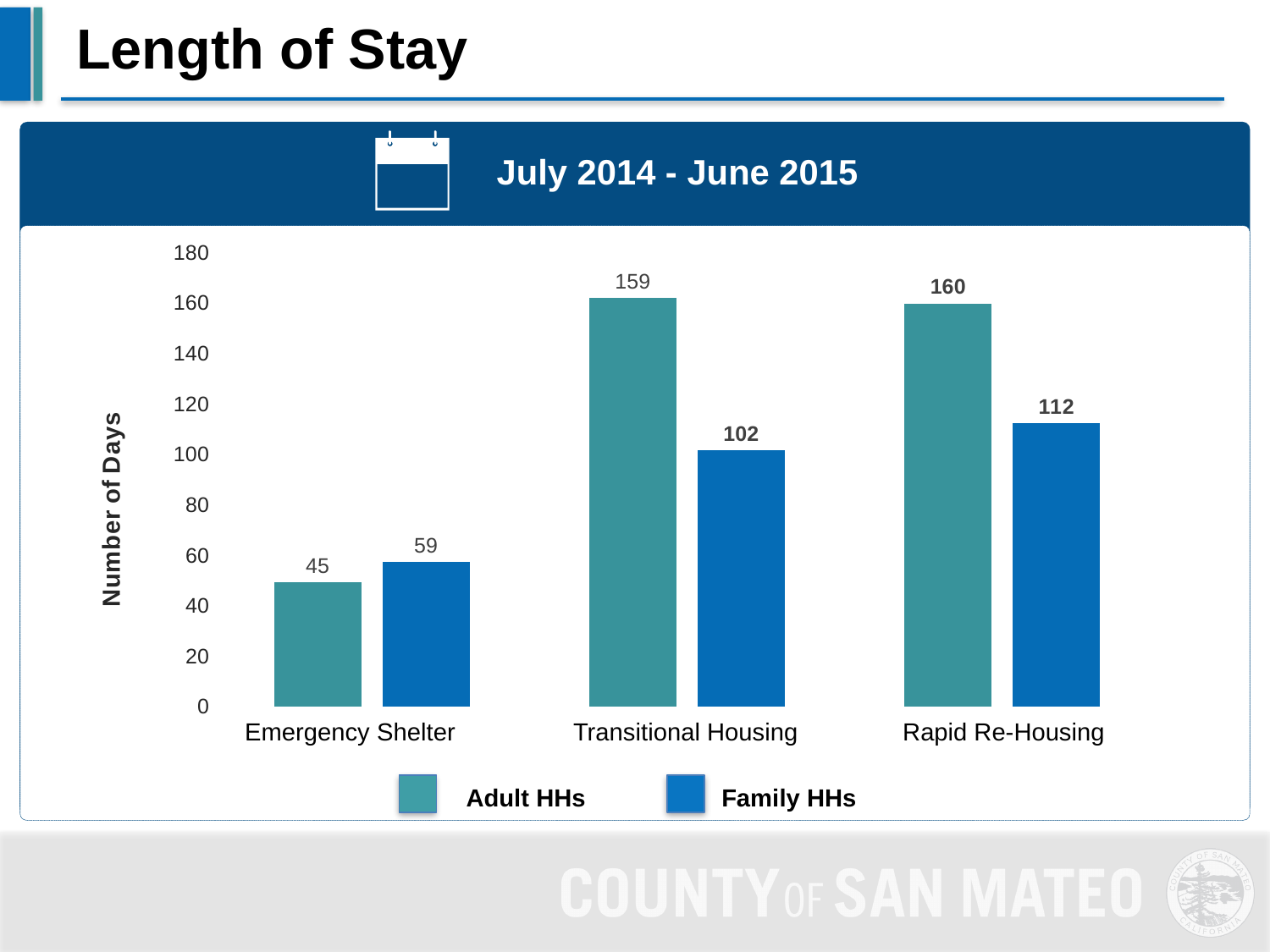
Which is larger in Emergency Shelter, Adult HHs or Family HHs? Family HHs How many categories are shown on the x axis? 3 What is the value for Adult HHs in Emergency Shelter? 45 Is the value for Adult HHs in Transitional Housing greater or less than 140? greater What is the value for Family HHs in Transitional Housing? 102 Which category has the lowest value for Family HHs? Emergency Shelter What is the label of the vertical axis? Number of Days What kind of chart is shown on the slide? bar chart What is the value for Family HHs in Rapid Re-Housing? 112 What is the difference between Adult HHs and Family HHs in Transitional Housing? 57 How many series does the legend list? 2